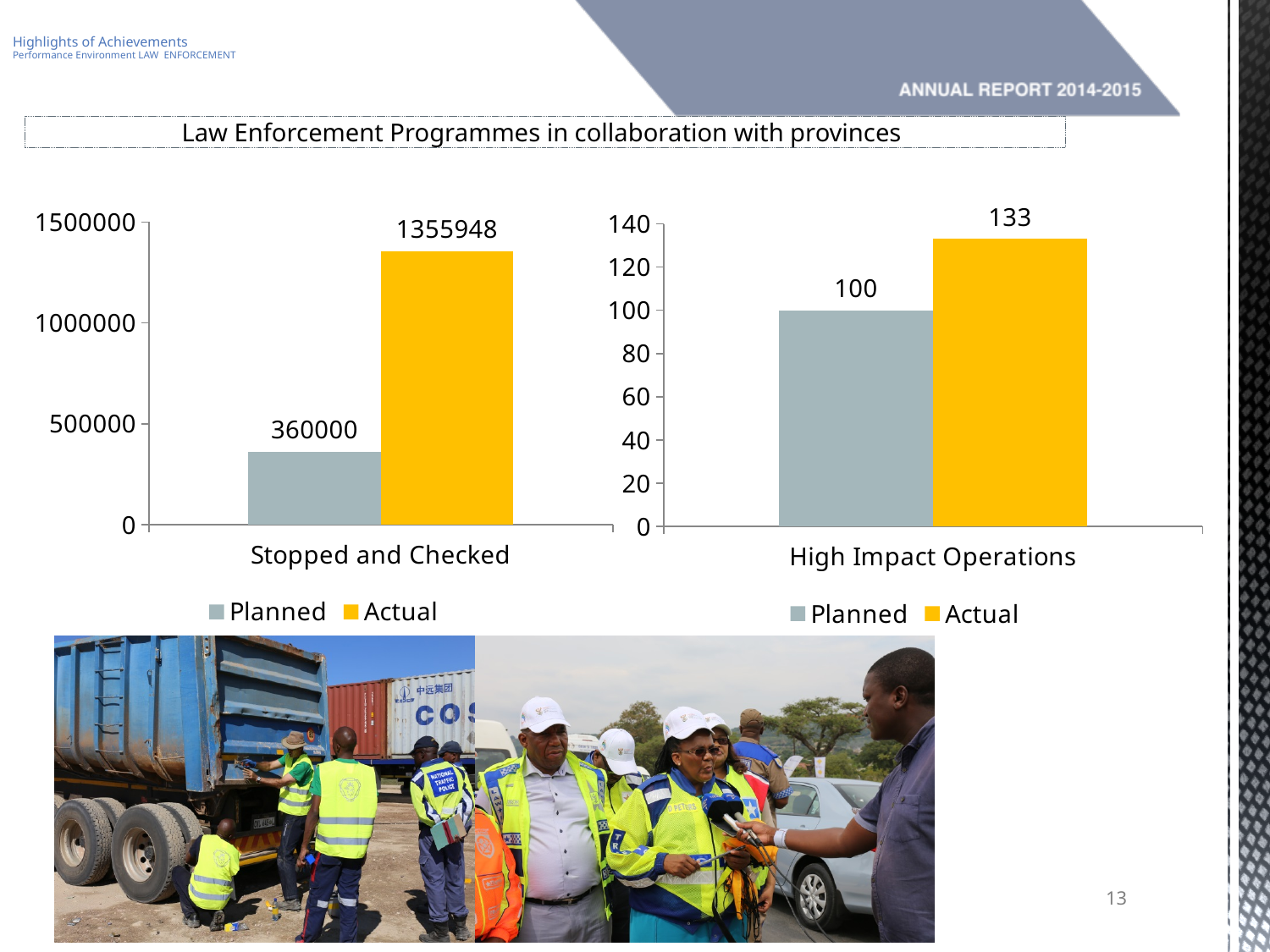
In the High Impact Operations chart, what colour is the Actual bar? yellow In the Stopped and Checked chart, is the Planned value greater or less than 500000? less How many series does the legend of the High Impact Operations chart list? 2 In the High Impact Operations chart, what is the Planned value? 100 What type of chart is the Stopped and Checked chart? bar chart In the Stopped and Checked chart, what is the Planned value? 360000 In the Stopped and Checked chart, which series has the higher value, Planned or Actual? Actual In the High Impact Operations chart, what is the difference between the Actual and Planned values? 33 In the Stopped and Checked chart, what is the difference between the Actual and Planned values? 995948 In the Stopped and Checked chart, what is the Actual value? 1355948 In the High Impact Operations chart, what is the Actual value? 133 In the High Impact Operations chart, which series has the lower value? Planned